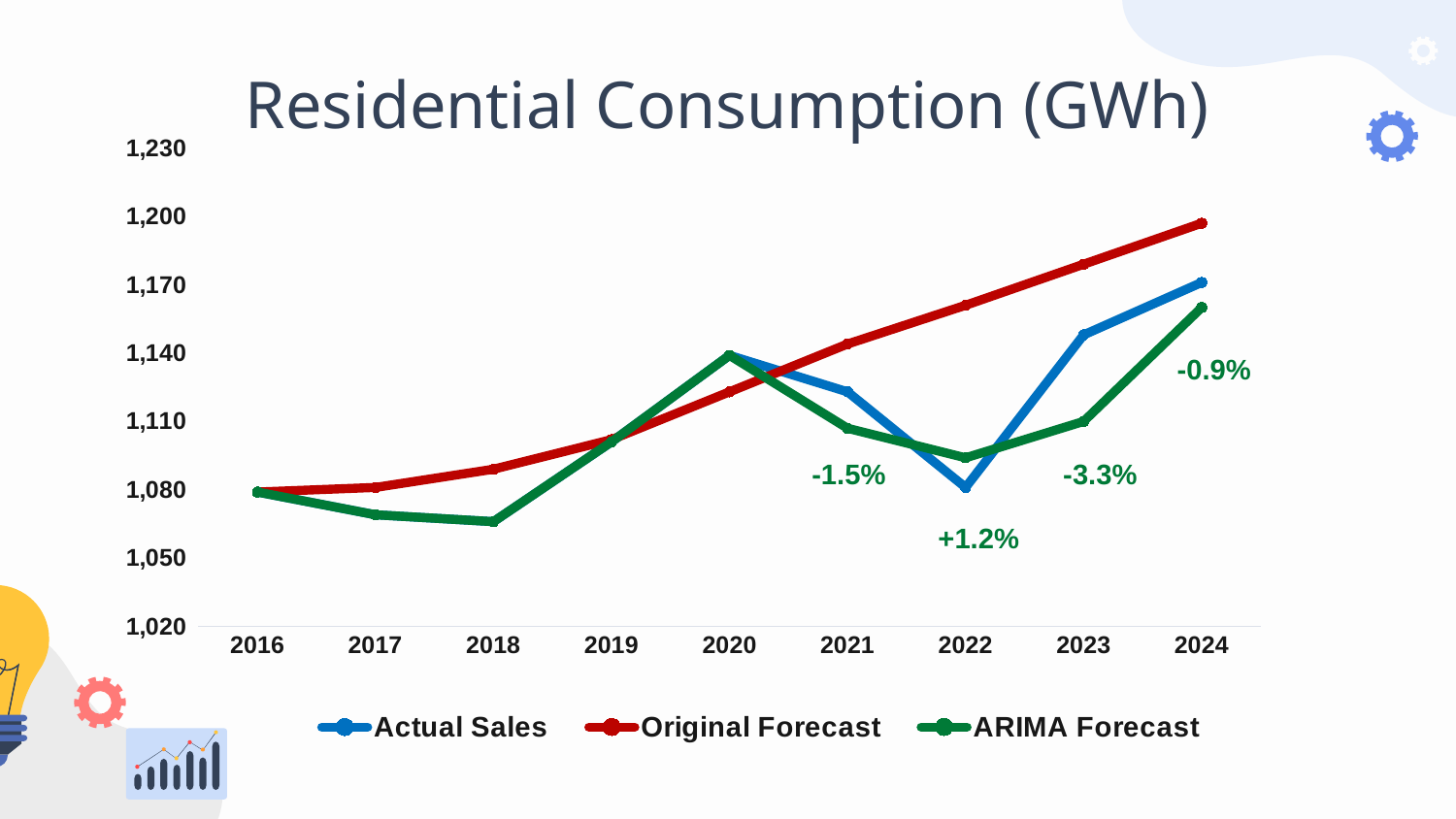
Which colour is used for the ARIMA Forecast line? green What is the title of the chart? Residential Consumption (GWh) Is the ARIMA Forecast value for 2018 greater or less than 1,080? less How many years are shown on the x axis? 9 What percentage label is printed near the 2022 point? +1.2% How many series does the legend list? 3 Is the Original Forecast value for 2023 greater or less than 1,170? greater In 2024, which is higher: Original Forecast or Actual Sales? Original Forecast What kind of chart is shown on the slide? line chart Is the Actual Sales value for 2023 greater or less than 1,140? greater In 2018, which is higher: Original Forecast or ARIMA Forecast? Original Forecast Does the Original Forecast line rise or fall from 2016 to 2024? rise